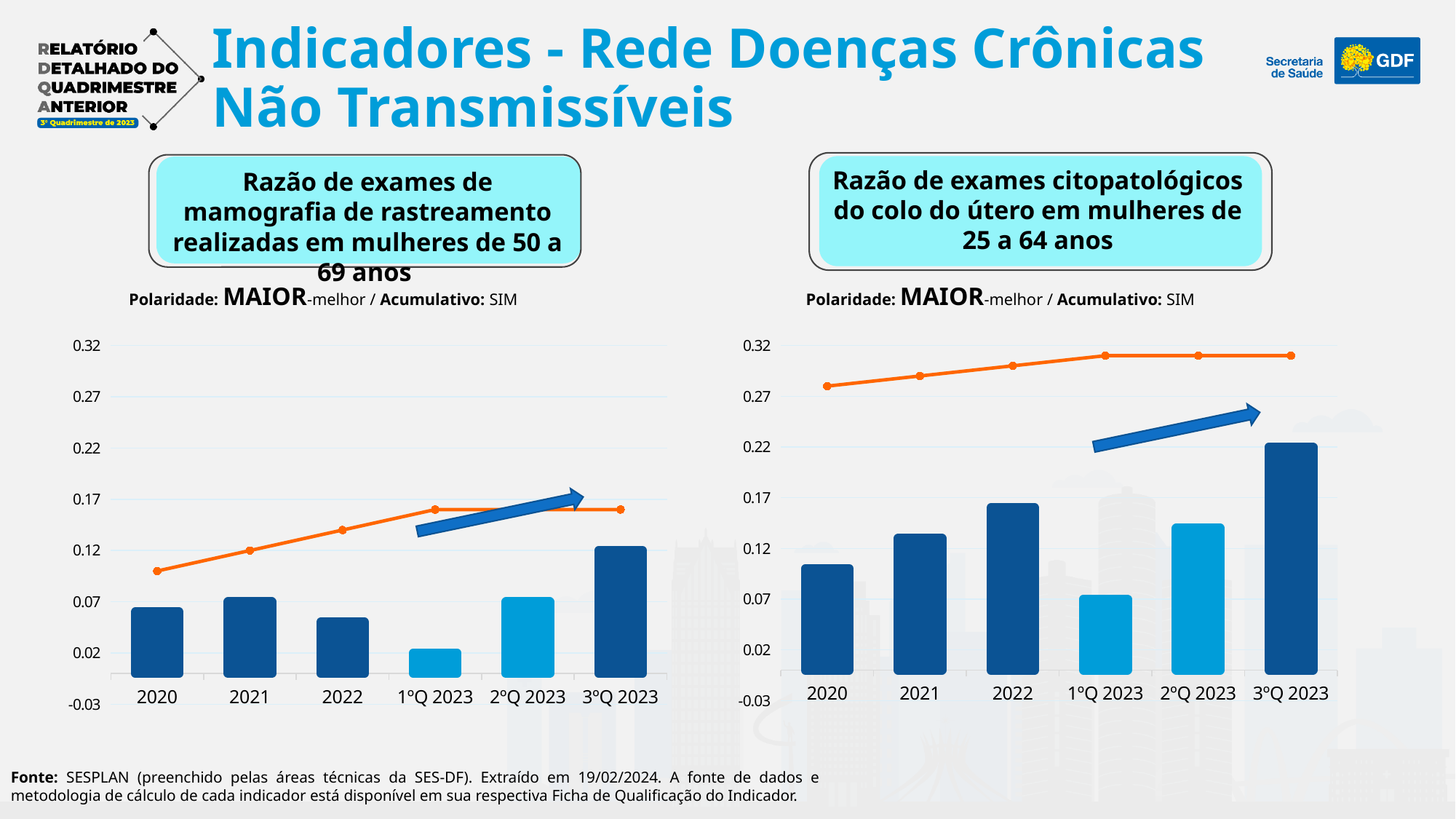
In the left chart, is the bar value for 1ºQ 2023 greater or less than 0.07? less In the right chart (Razão de exames citopatológicos), which category has the shortest bar? 1ºQ 2023 In the left chart (Razão de exames de mamografia), which category has the shortest bar? 1ºQ 2023 In the right chart, does the orange line rise or fall from 2020 to 1ºQ 2023? rises In the left chart, is the bar value for 3ºQ 2023 greater or less than 0.07? greater In the left chart (Razão de exames de mamografia), which category has the tallest bar? 3ºQ 2023 In the right chart, is the bar value for 3ºQ 2023 greater or less than 0.17? greater How many categories are shown on the x axis of the left chart? 6 In the right chart (Razão de exames citopatológicos), which category has the tallest bar? 3ºQ 2023 In the right chart, which bar is taller, 2021 or 2022? 2022 In the left chart, which bar is taller, 2020 or 2022? 2020